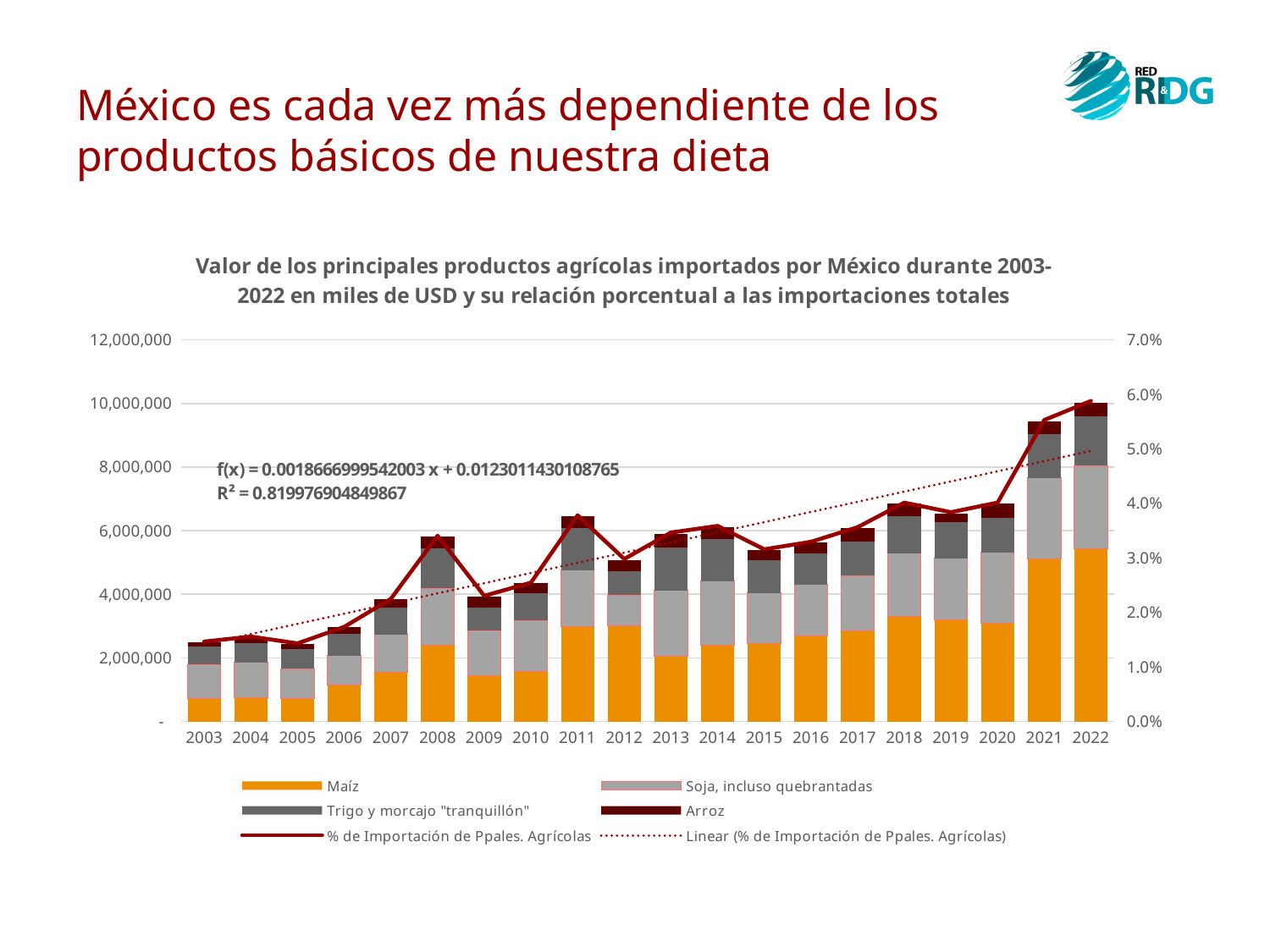
Which year has the larger total stacked bar, 2016 or 2021? 2021 Is the '% de Importación de Ppales. Agrícolas' value for 2003 greater or less than 2.0%? less What kind of chart is shown on the slide? combination bar and line chart Does the '% de Importación de Ppales. Agrícolas' line generally rise or fall from 2003 to 2022? rise What R² value is printed on the chart for the linear trend line? 0.819976904849867 Which year has the highest total stacked bar? 2022 How many entries does the chart's legend list? 6 Is the '% de Importación de Ppales. Agrícolas' value for 2022 greater or less than 5.0%? greater Is the total stacked bar for 2003 greater or less than 4,000,000? less How many years are shown along the x axis of the chart? 20